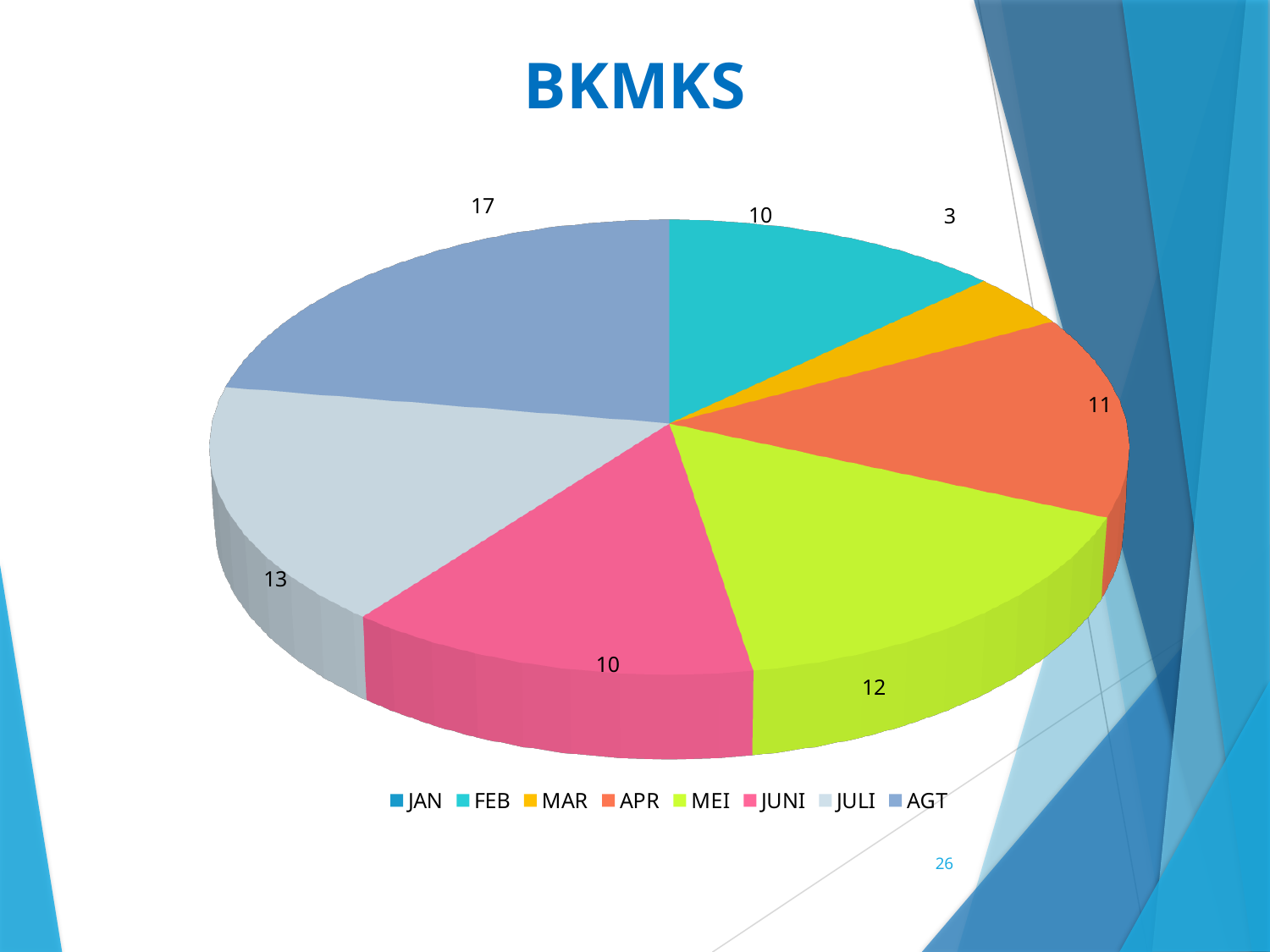
What is the value of the MEI slice? 12 What is the difference between the AGT value and the MAR value? 14 How many entries does the legend list? 8 What is the value of the AGT slice? 17 What kind of chart is shown on the slide? Pie chart What is the value of the MAR slice? 3 What is the title of the chart? BKMKS Which month has the smallest labelled slice in the pie chart? MAR What is the value of the JULI slice? 13 Which month has the largest slice in the pie chart? AGT Which is larger, the JULI slice or the MEI slice? JULI What is the value of the APR slice? 11